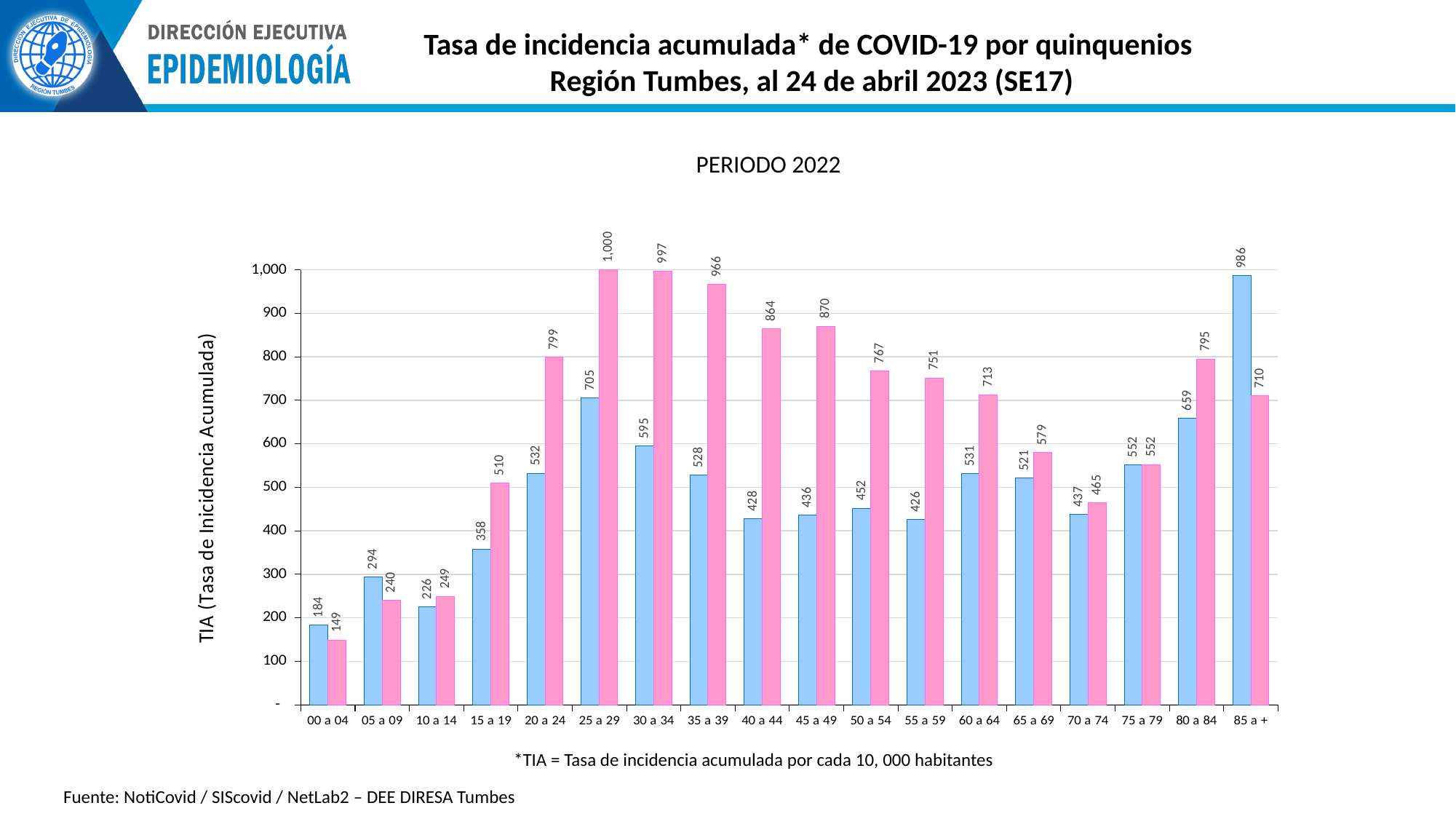
What is the value of the blue bar for the 25 a 29 age group? 705 For the 85 a + age group, which bar is larger, the blue or the pink? blue How many age groups are shown on the x axis? 18 What kind of chart is shown on the slide? bar chart What is the title shown above the chart? PERIODO 2022 Which age group has the highest pink bar? 25 a 29 What is the value of the blue bar for the 85 a + age group? 986 What is the value of the pink bar for the 40 a 44 age group? 864 Is the value of the pink bar for the 35 a 39 age group greater or less than 900? greater Do the pink bars rise or fall from the 00 a 04 group to the 25 a 29 group? rise What is the difference between the pink and blue bars for the 25 a 29 age group? 295 Which age group has the lowest blue bar? 00 a 04